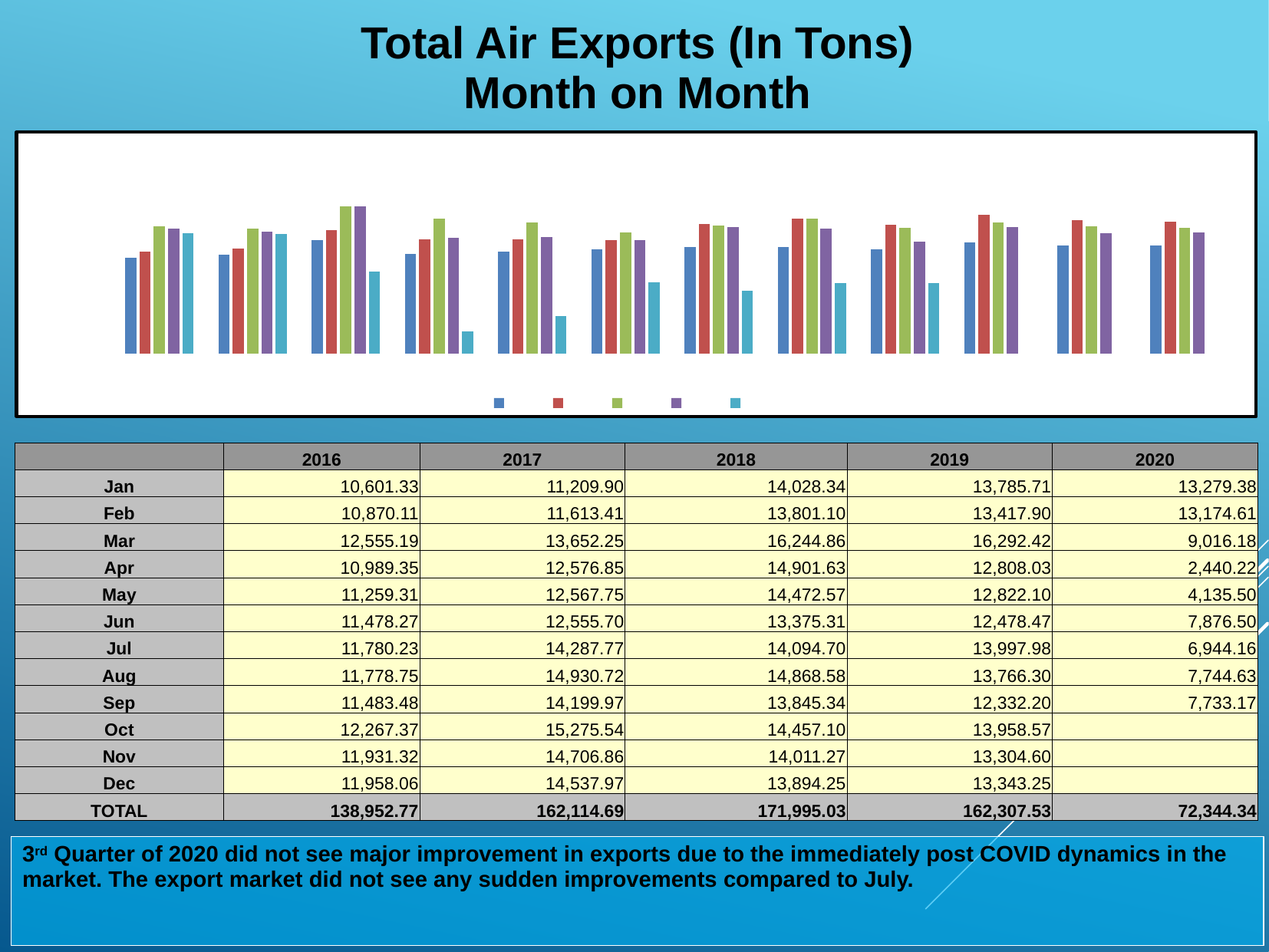
Which month has the lowest air exports in 2020? Apr What is the Total Air Exports value for Apr 2020? 2,440.22 What is the Total Air Exports value for Mar 2018? 16,244.86 Which year has the highest TOTAL air exports? 2018 What kind of chart is shown on the slide? bar chart Which month has the highest air exports in 2019? Mar What is the difference between the 2018 TOTAL and the 2017 TOTAL? 9,880.34 How many series does the chart's legend show? 5 How many groups of bars (months) are plotted in the chart? 12 Which is larger, the Jul value for 2017 or the Jul value for 2018? 2017 Which year has the lowest TOTAL air exports? 2020 What is the Total Air Exports value for Jan 2016? 10,601.33